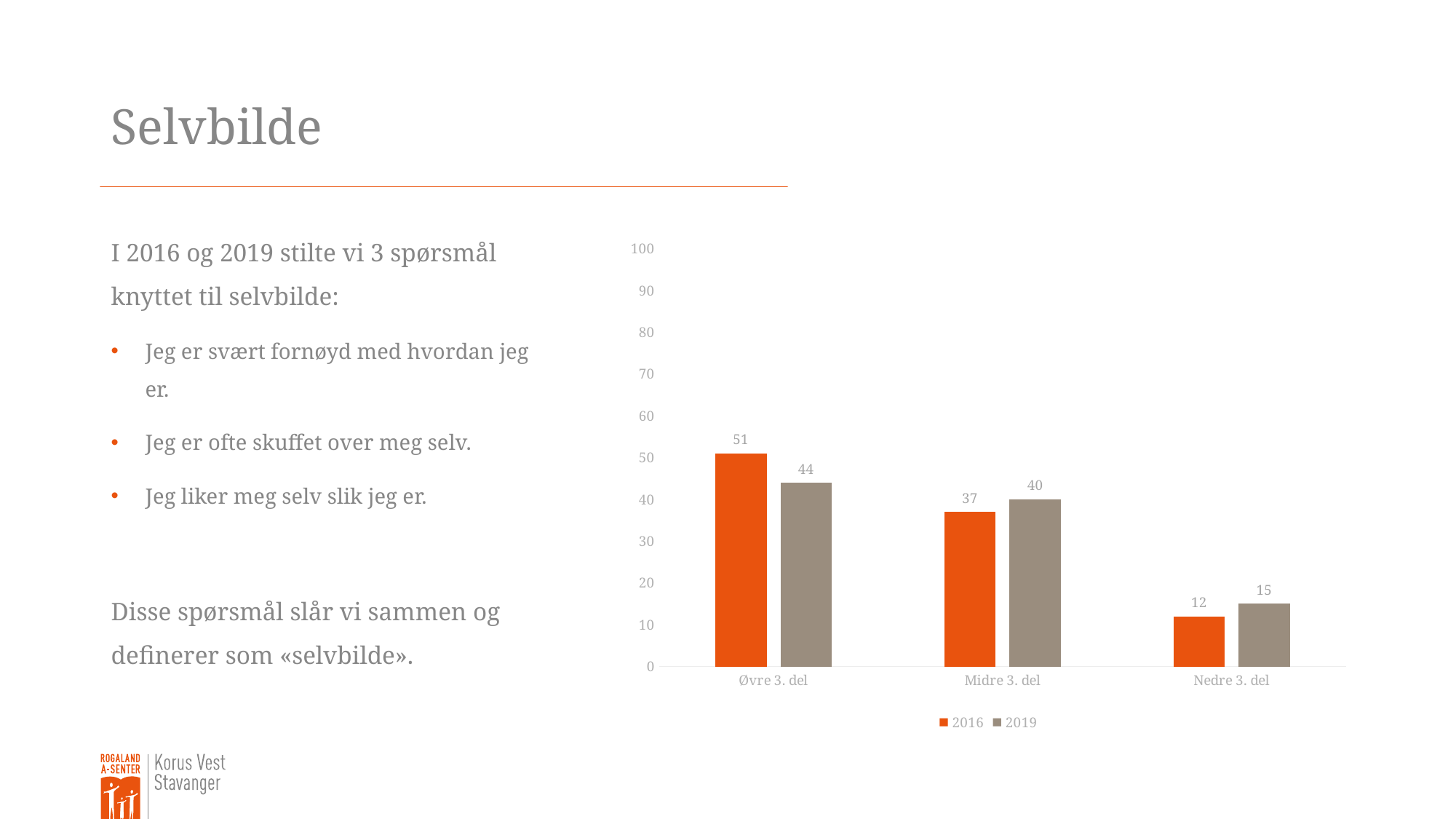
How many series does the legend list? 2 What kind of chart is shown on the slide? bar chart How many categories are shown on the x axis? 3 What is the value for 2016 in the Øvre 3. del category? 51 What is the value for 2019 in the Nedre 3. del category? 15 In the Midre 3. del category, which series has the larger value, 2016 or 2019? 2019 Which category has the lowest value for the 2019 series? Nedre 3. del What is the value for 2019 in the Midre 3. del category? 40 Do the 2016 values rise or fall from Øvre 3. del to Nedre 3. del? fall Which category has the highest value for the 2016 series? Øvre 3. del What is the difference between the 2016 and 2019 values in the Øvre 3. del category? 7 Is the value for 2016 in the Nedre 3. del category greater or less than 20? less